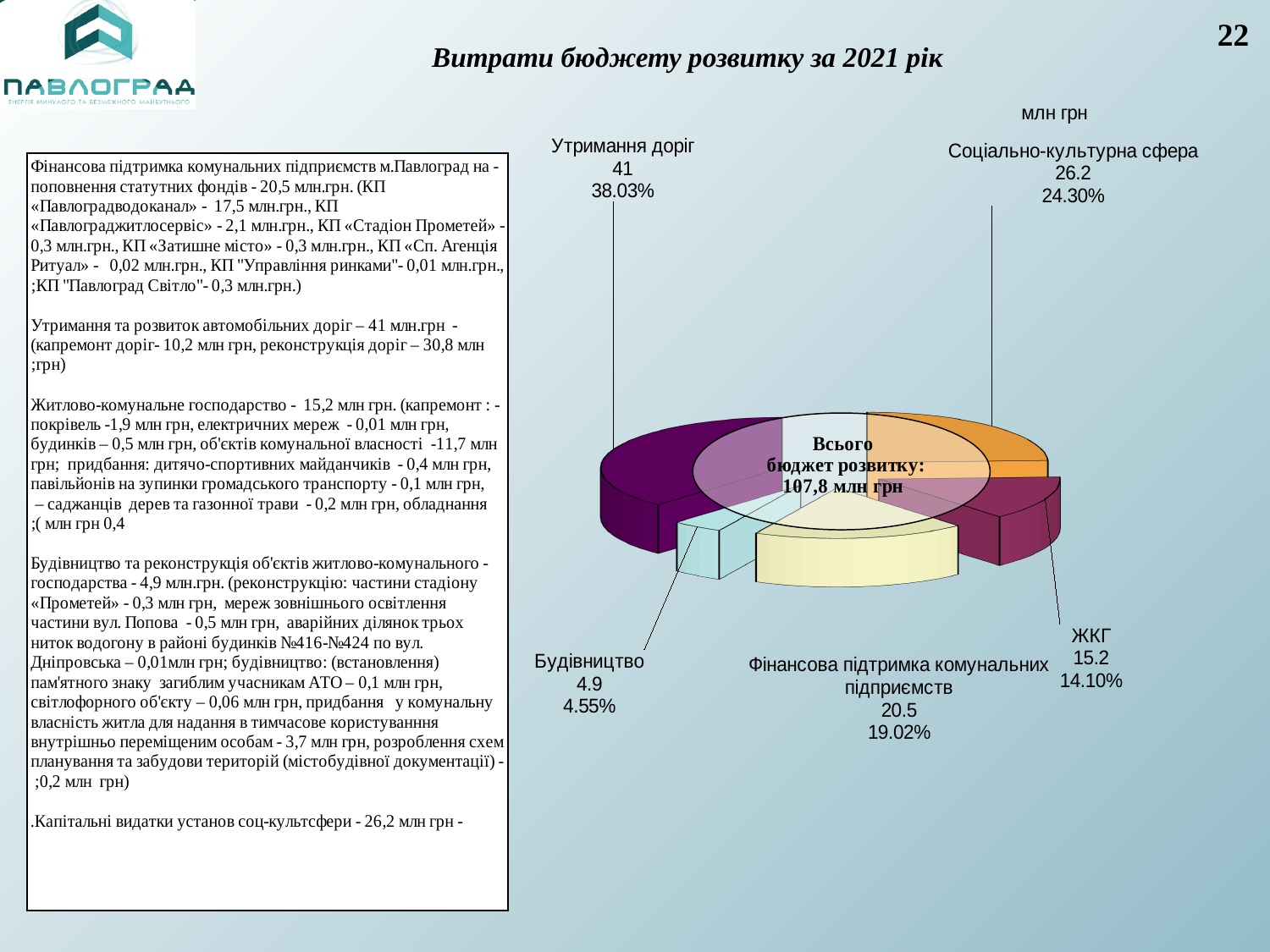
Which category has the smallest slice? Будівництво What is the value for Будівництво? 4.9 What is the value for Соціально-культурна сфера? 26.2 How many slices does the pie chart have? 5 What type of chart is shown on the slide? pie chart What share of the pie does Будівництво represent? 4.55% What is the value for Утримання доріг? 41 What is the difference between the values for Утримання доріг and ЖКГ? 25.8 What total is printed in the centre of the pie chart? 107,8 млн грн What is the value for ЖКГ? 15.2 What share of the pie does Фінансова підтримка комунальних підприємств represent? 19.02% Which category has the largest slice? Утримання доріг